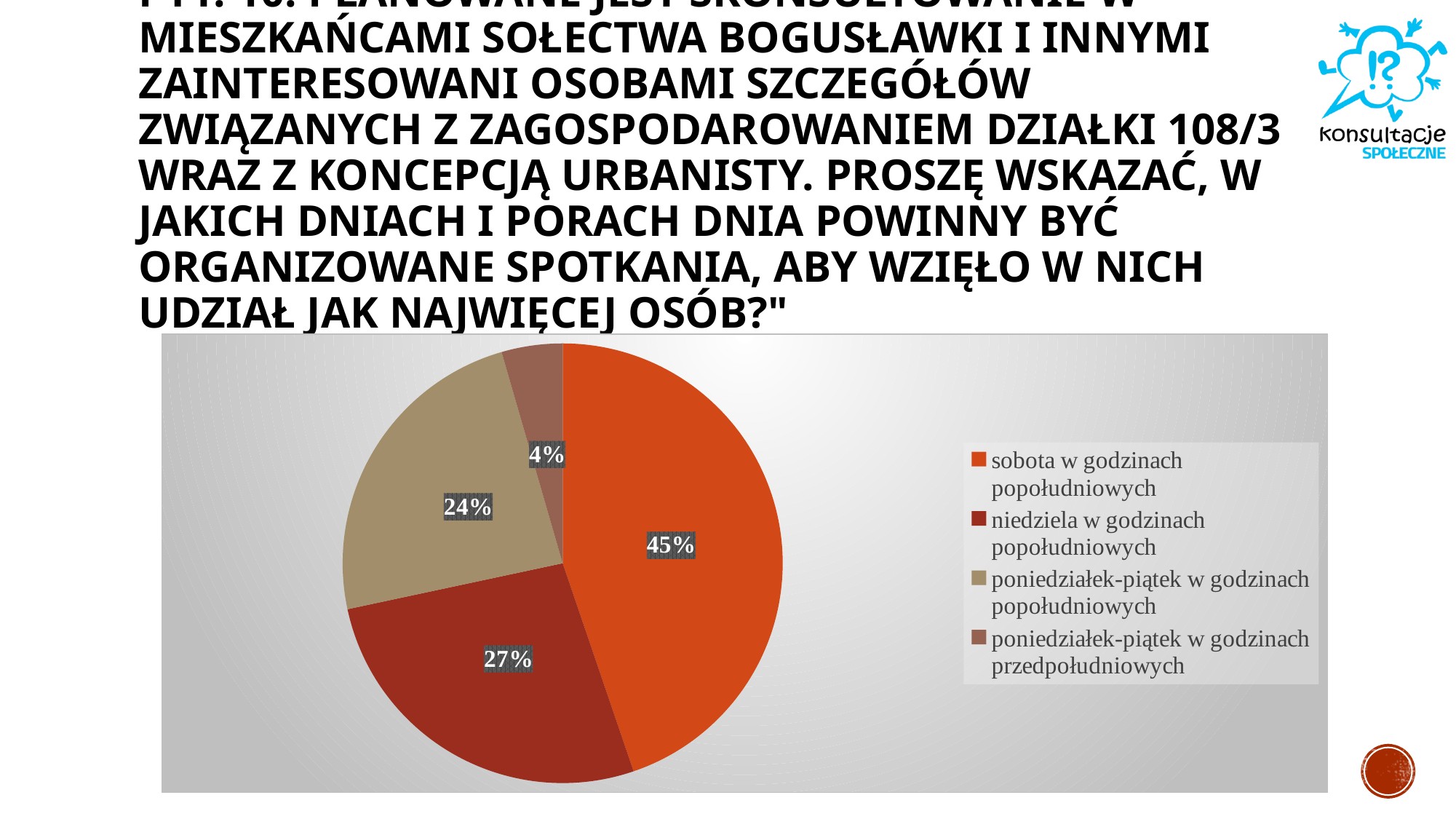
Which category has the largest share of the pie? sobota w godzinach popołudniowych What is the difference in percentage points between 'sobota w godzinach popołudniowych' and 'niedziela w godzinach popołudniowych'? 18 What share of the pie does 'poniedziałek-piątek w godzinach przedpołudniowych' have? 4% What colour is the slice for 'poniedziałek-piątek w godzinach popołudniowych'? tan/beige How many categories does the pie chart show? 4 What share of the pie does 'sobota w godzinach popołudniowych' have? 45% What share of the pie does 'poniedziałek-piątek w godzinach popołudniowych' have? 24% What kind of chart is shown on the slide? pie chart Which category has the smallest share of the pie? poniedziałek-piątek w godzinach przedpołudniowych What is the difference in percentage points between 'poniedziałek-piątek w godzinach popołudniowych' and 'poniedziałek-piątek w godzinach przedpołudniowych'? 20 What share of the pie does 'niedziela w godzinach popołudniowych' have? 27% Which is larger: the share for 'niedziela w godzinach popołudniowych' or for 'poniedziałek-piątek w godzinach popołudniowych'? niedziela w godzinach popołudniowych